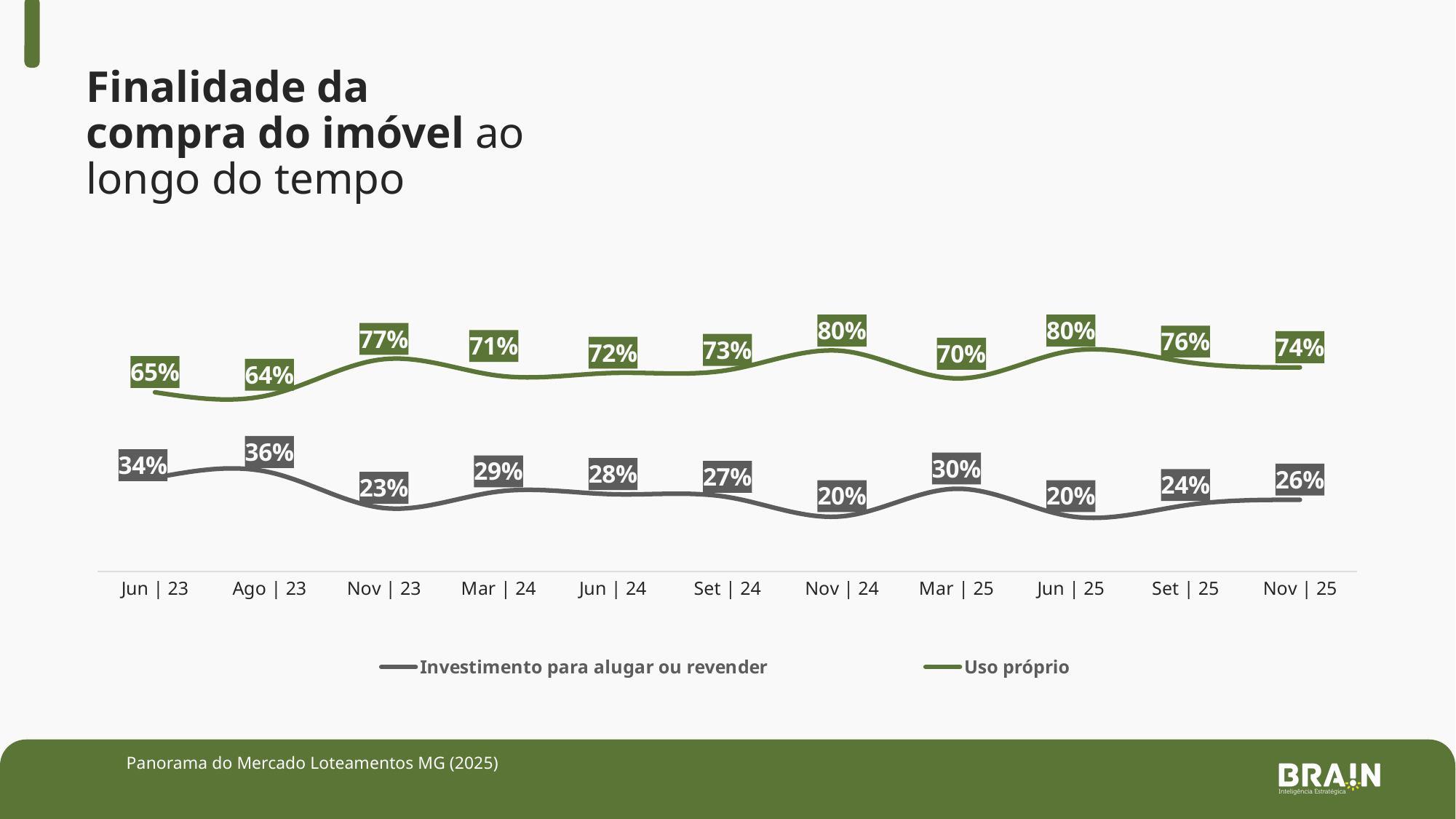
What kind of chart is shown on the slide? Line chart What is the value for Investimento para alugar ou revender in Mar | 25? 30% Does the value for Investimento para alugar ou revender rise or fall from Jun | 23 to Nov | 25? Fall How many time points are plotted along the x axis? 11 In which period is the value for Investimento para alugar ou revender highest? Ago | 23 In which period is the value for Uso próprio lowest? Ago | 23 What is the value for Uso próprio in Nov | 25? 74% Which series is drawn in green? Uso próprio How many series does the legend list? 2 What is the value for Uso próprio in Nov | 23? 77% What is the difference between Uso próprio and Investimento para alugar ou revender in Jun | 25? 60% Which is larger in Jun | 23: Uso próprio or Investimento para alugar ou revender? Uso próprio